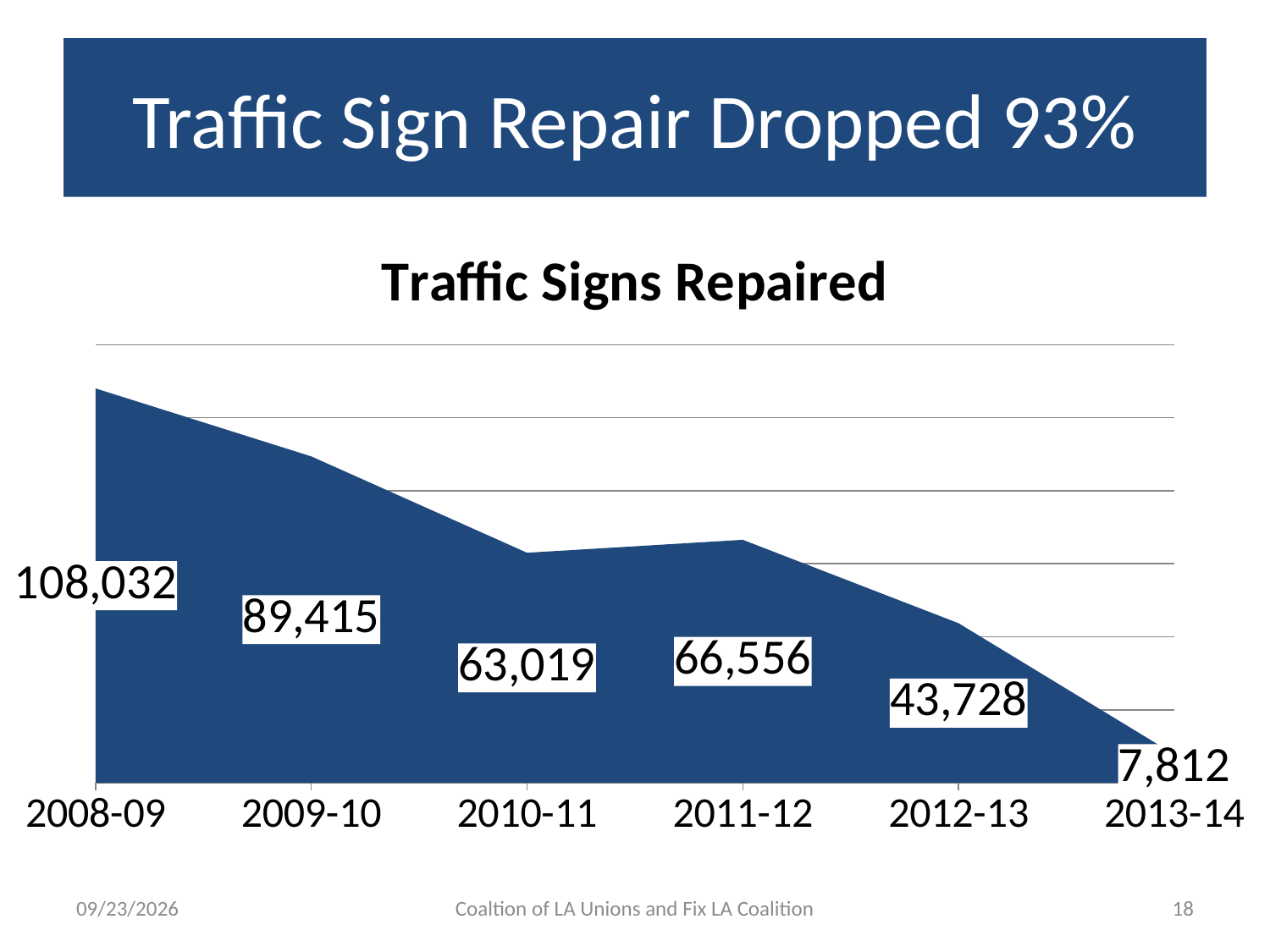
What is the title of the chart? Traffic Signs Repaired Which year has the highest number of traffic signs repaired? 2008-09 What is the value for 2012-13? 43,728 How many years are plotted on the x axis? 6 What is the value shown for 2013-14? 7,812 What kind of chart is shown on the slide? Area chart Which year has the lowest number of traffic signs repaired? 2013-14 Which is larger, the value for 2010-11 or the value for 2011-12? 2011-12 How many traffic signs were repaired in 2011-12? 66,556 What is the difference between the values for 2009-10 and 2010-11? 26,396 What is the value for 2008-09 in the Traffic Signs Repaired chart? 108,032 What is the difference between the values for 2008-09 and 2013-14? 100,220